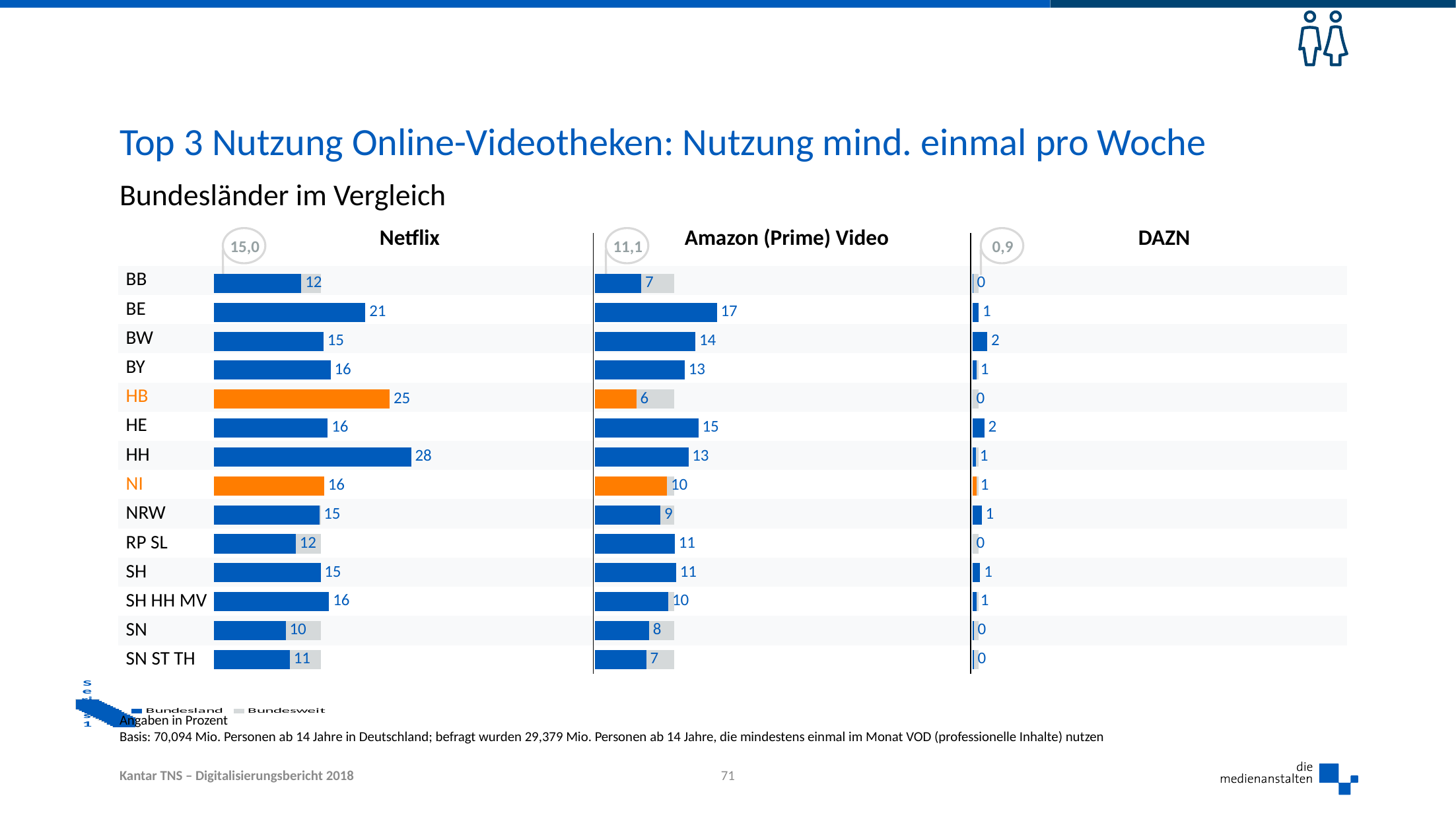
How many series does the legend list? 2 In the Netflix chart, what is the value for HH? 28 In the Netflix chart, which Bundesland has the highest value? HH What kind of chart is used for the Netflix data? bar chart In the Amazon (Prime) Video chart, what is the value for BE? 17 What is the Bundesweit (nationwide) value shown in the circle for the Amazon (Prime) Video chart? 11,1 In the Amazon (Prime) Video chart, which Bundesland has the lowest value? HB In the DAZN chart, what is the value for BW? 2 In the Netflix chart, what is the difference between the values for HB and BB? 13 How many Bundesländer (categories) are shown in the Netflix chart? 14 In the Netflix chart, which Bundesland has the lowest value? SN In the Amazon (Prime) Video chart, which is larger, the value for BW or the value for NRW? BW